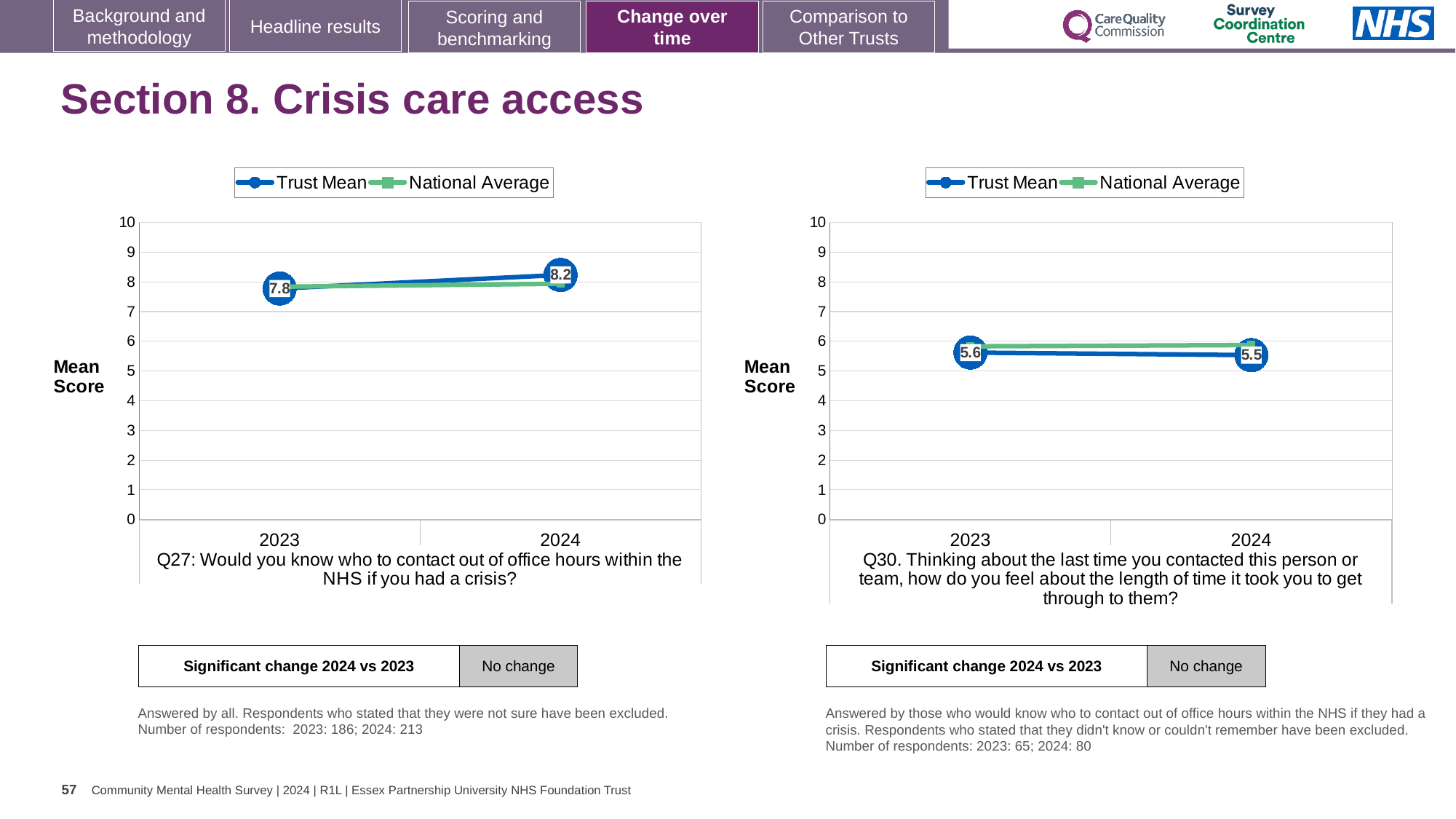
In the Q30 chart on the right, is the National Average for 2023 greater or less than 5? greater What type of chart is the Q27 chart on the left? line chart In the Q30 chart on the right, what is the difference between the Trust Mean for 2023 and 2024? 0.1 In the Q27 chart on the left, what is the Trust Mean score for 2023? 7.8 In the Q27 chart on the left, what is the Trust Mean score for 2024? 8.2 In the Q30 chart on the right, does the Trust Mean rise or fall from 2023 to 2024? fall In the Q27 chart on the left, does the Trust Mean rise or fall from 2023 to 2024? rise In the Q30 chart on the right, what is the Trust Mean score for 2024? 5.5 In the Q27 chart on the left, by how much did the Trust Mean change from 2023 to 2024? 0.4 In the Q30 chart on the right, which is higher in 2024, the Trust Mean or the National Average? National Average In the Q30 chart on the right, what is the Trust Mean score for 2023? 5.6 How many series does the legend of the Q30 chart on the right list? 2